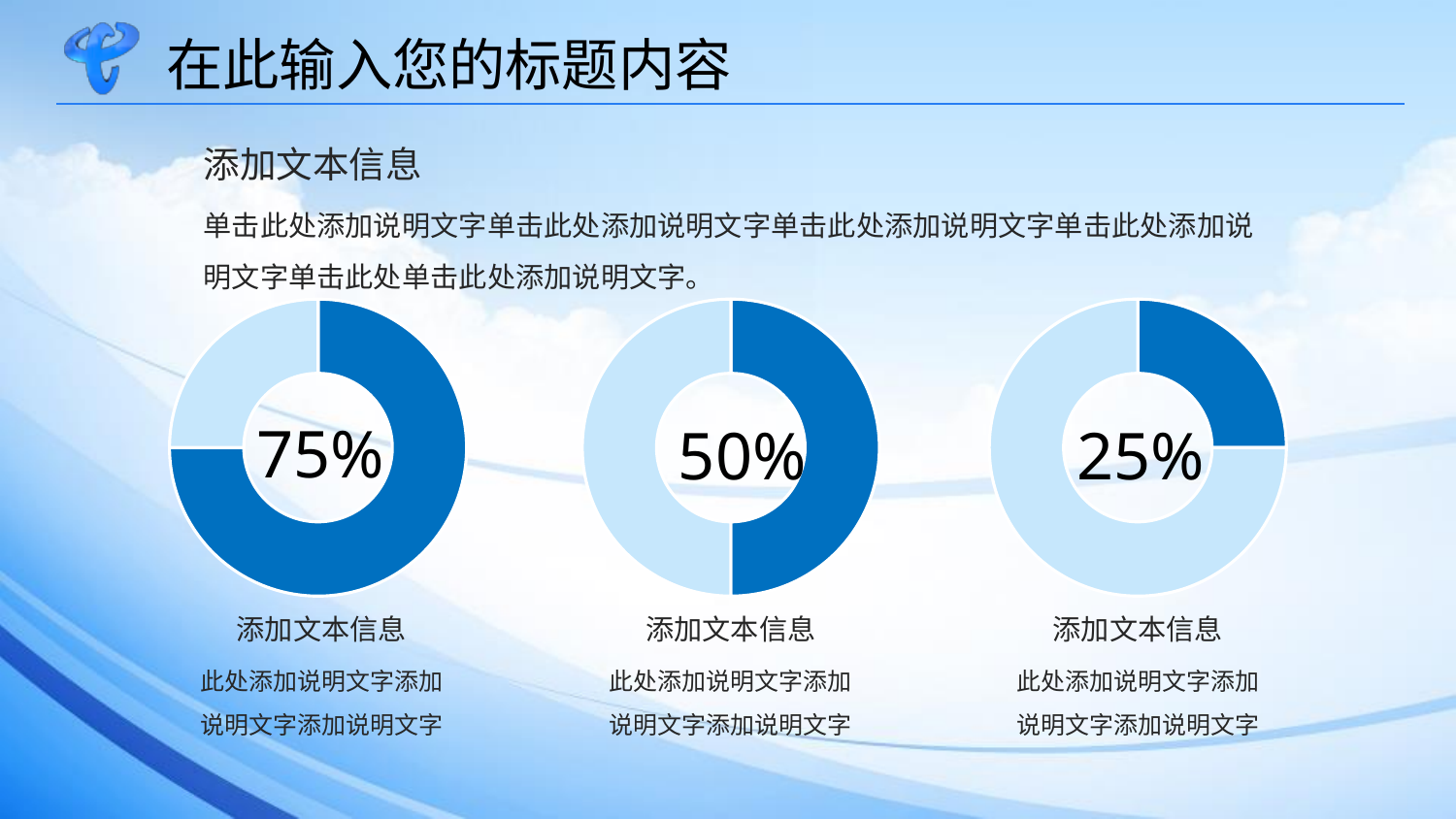
What kind of chart is used to display the percentages on the slide? Doughnut chart What percentage is shown in the centre of the middle doughnut chart? 50% What is the difference between the percentage in the left chart and the percentage in the right chart? 50% Which of the three doughnut charts shows the highest percentage? The left chart (75%) What percentage is shown in the centre of the left doughnut chart? 75% What is the difference between the percentage in the left chart and the percentage in the middle chart? 25% In the left doughnut chart, what share of the ring is filled with the dark blue colour? 75% Do the percentages shown in the charts increase or decrease from left to right across the slide? Decrease Which of the three doughnut charts shows the lowest percentage? The right chart (25%) How many doughnut charts are on the slide? 3 What percentage is shown in the centre of the right doughnut chart? 25% Is the percentage in the middle chart larger or smaller than the percentage in the right chart? Larger